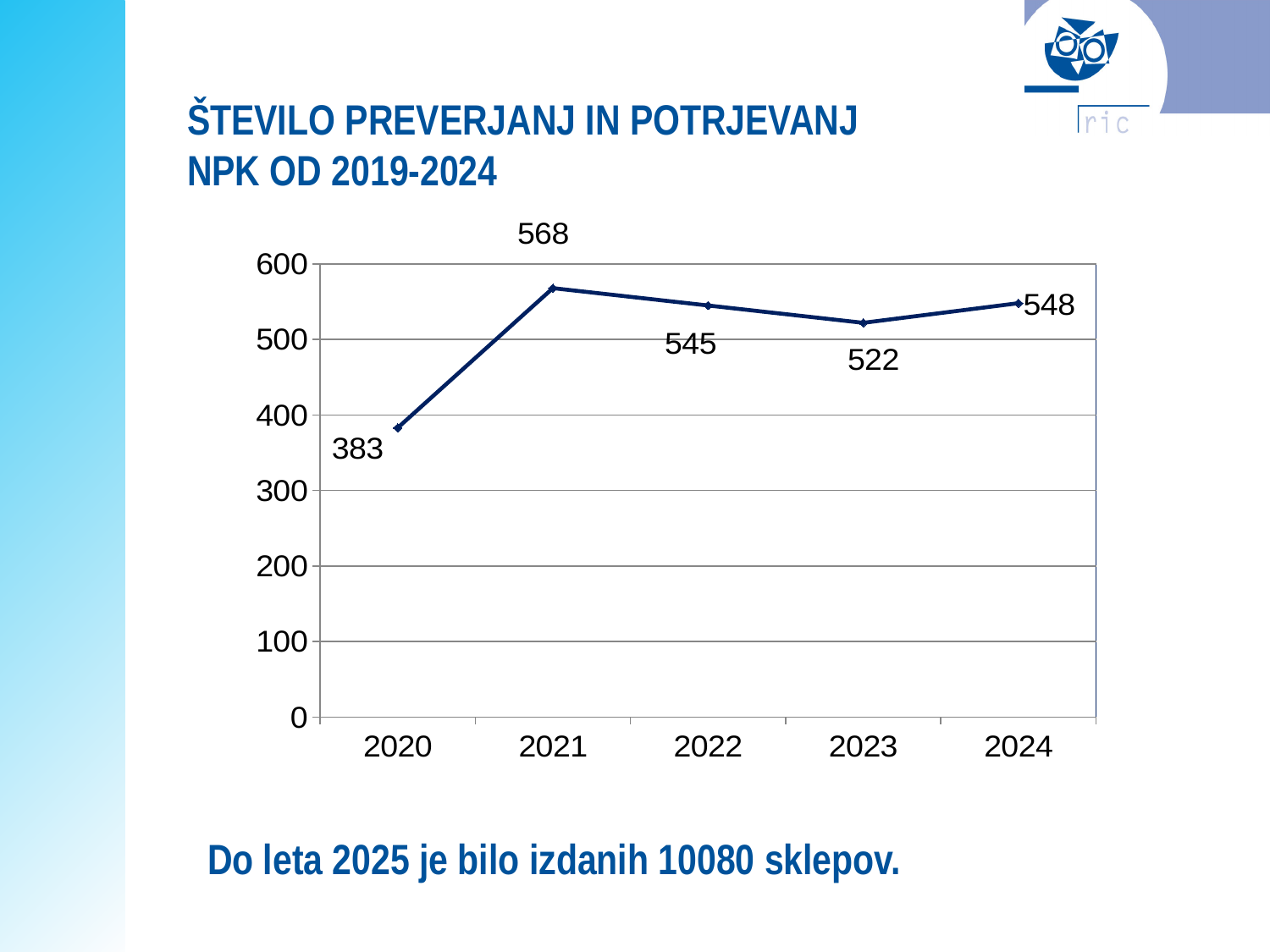
What is the value for 2021? 568 Is the value for 2020 greater or less than 400? less Which is larger, the value for 2022 or the value for 2023? 2022 How many years are plotted on the x axis? 5 Which year has the highest value? 2021 What is the value for 2024? 548 What kind of chart is shown on the slide? line chart Which year has the lowest value? 2020 What is the difference between the values for 2022 and 2023? 23 What is the difference between the values for 2021 and 2020? 185 What is the value for 2023? 522 What is the value for 2020? 383